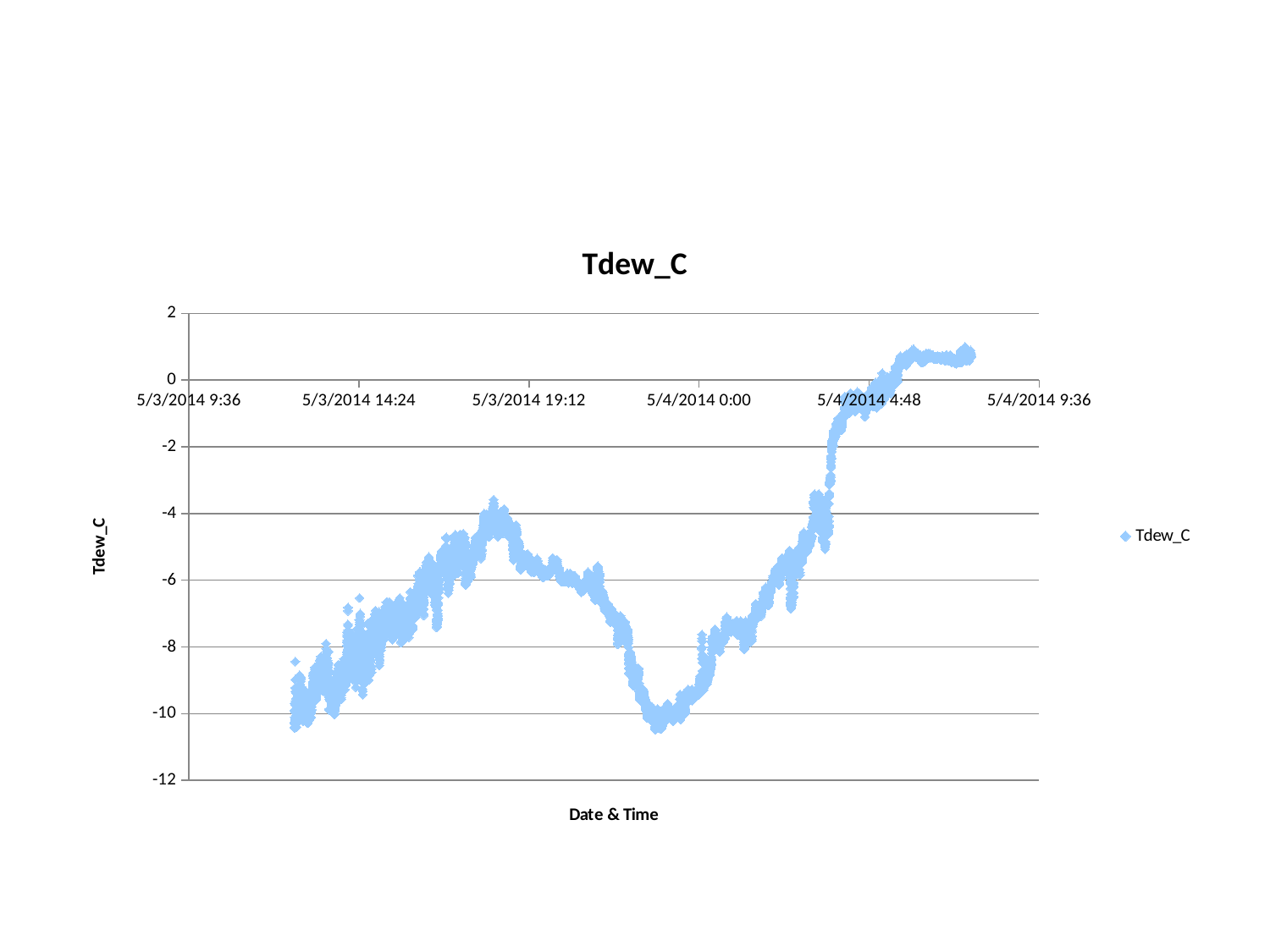
How many series does the legend list? 1 Overall, do the Tdew_C values rise or fall from the start of the series to the end? rise What kind of chart is shown on the slide? scatter chart Do the Tdew_C values at the end of the series (around 5/4/2014 7:00) lie above or below 0? above What is the title of the chart? Tdew_C Is the value of Tdew_C at 5/3/2014 19:12 greater or less than -4? less Are the highest Tdew_C values found near the start or near the end of the time range? near the end Is the value of Tdew_C at 5/3/2014 14:24 greater or less than -6? less Between 5/3/2014 19:12 and 5/4/2014 0:00, do the Tdew_C values rise or fall? fall What is the label on the x axis of the chart? Date & Time